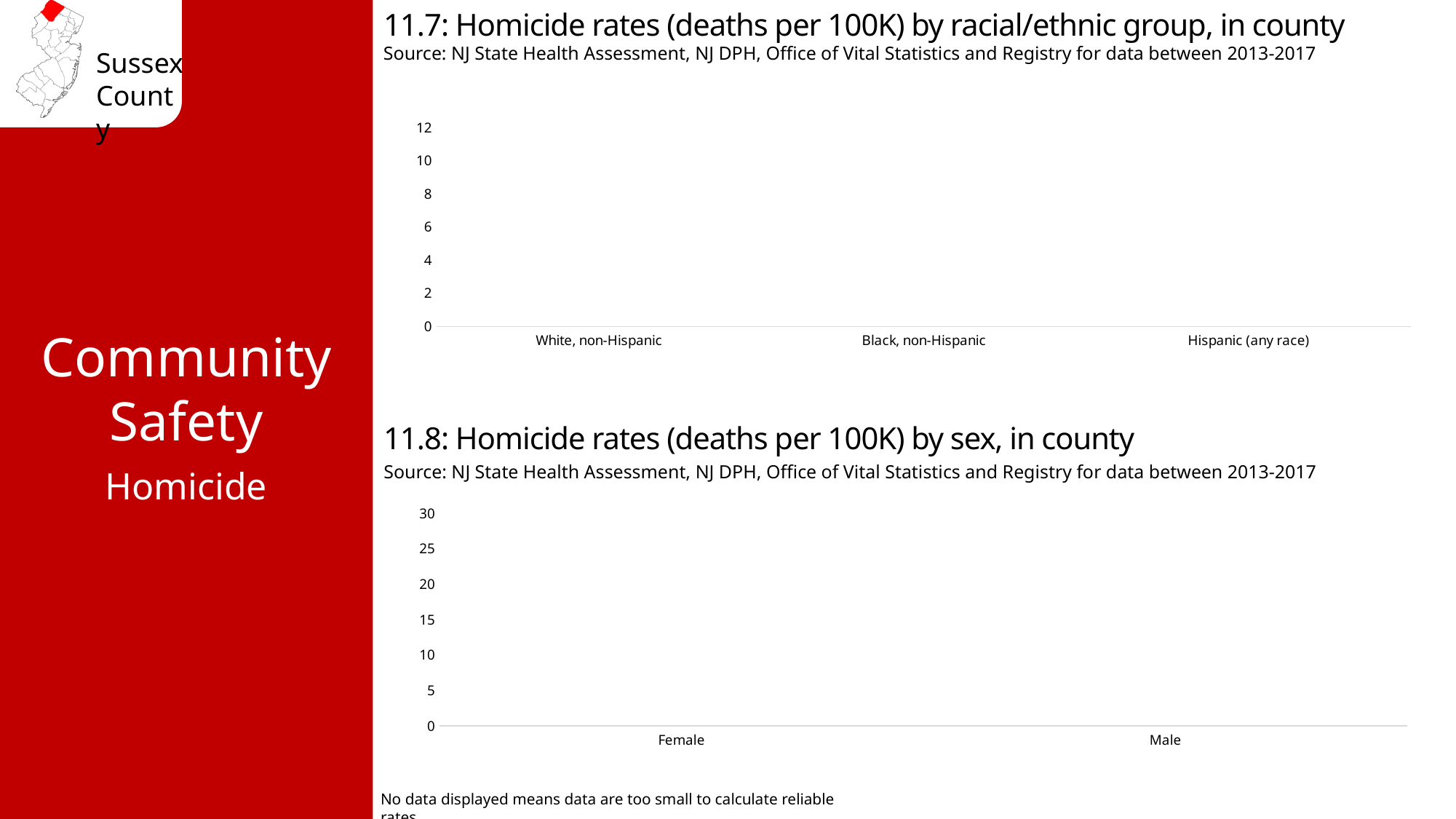
In the bottom chart (11.8), are any bars or data values plotted for Female or Male? No In the chart titled "11.8: Homicide rates (deaths per 100K) by sex, in county", how many categories are listed on the x axis? 2 In the top chart (11.7), what is the highest value shown on the y axis? 12 In the top chart (11.7), are any bars or data values plotted for the categories? No In the bottom chart (11.8), what is the highest value shown on the y axis? 30 In the chart titled "11.7: Homicide rates (deaths per 100K) by racial/ethnic group, in county", how many categories are listed on the x axis? 3 In the top chart (11.7), what are the three categories on the x axis? White, non-Hispanic; Black, non-Hispanic; Hispanic (any race) In the bottom chart (11.8), what are the two categories on the x axis? Female, Male